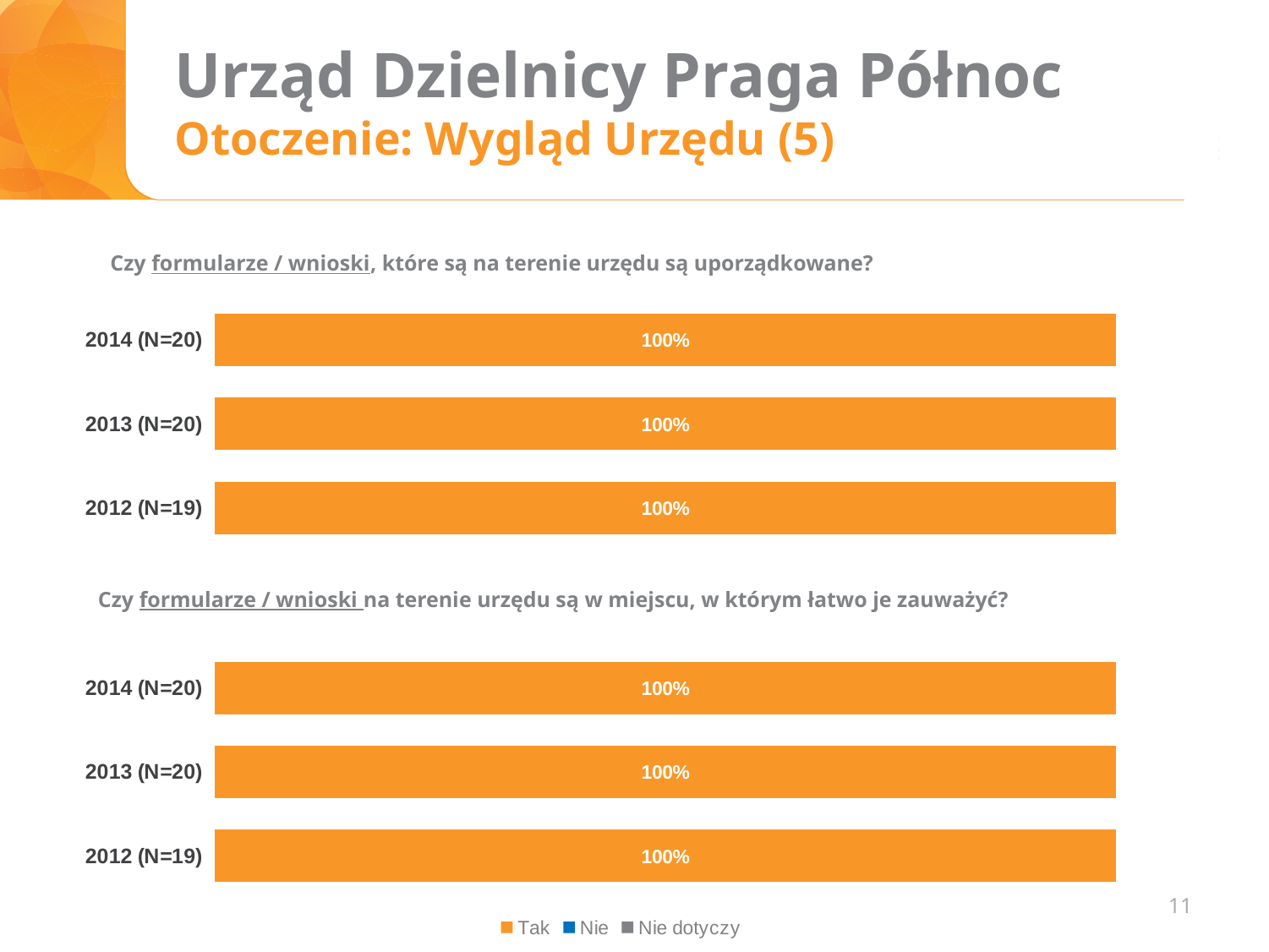
In the top chart, what is the difference between the values for 2014 (N=20) and 2012 (N=19)? 0% In the bottom chart ("Czy formularze / wnioski na terenie urzędu są w miejscu, w którym łatwo je zauważyć?"), what is the value for 2013 (N=20)? 100% What are the three entries listed in the legend? Tak, Nie, Nie dotyczy What kind of chart is the top chart? Bar chart In the top chart, what is the value for 2012 (N=19)? 100% In the bottom chart, what is the value for 2012 (N=19)? 100% How many categories (years) are shown in the bottom chart? 3 In the bottom chart, which answer category does the 100% value for 2014 (N=20) belong to? Tak In the top chart ("Czy formularze / wnioski, które są na terenie urzędu są uporządkowane?"), what is the value for 2014 (N=20)? 100% How many categories (years) are shown in the top chart? 3 How many series does the legend at the bottom of the slide list? 3 In the top chart, is the value for 2013 (N=20) greater or less than 50%? greater